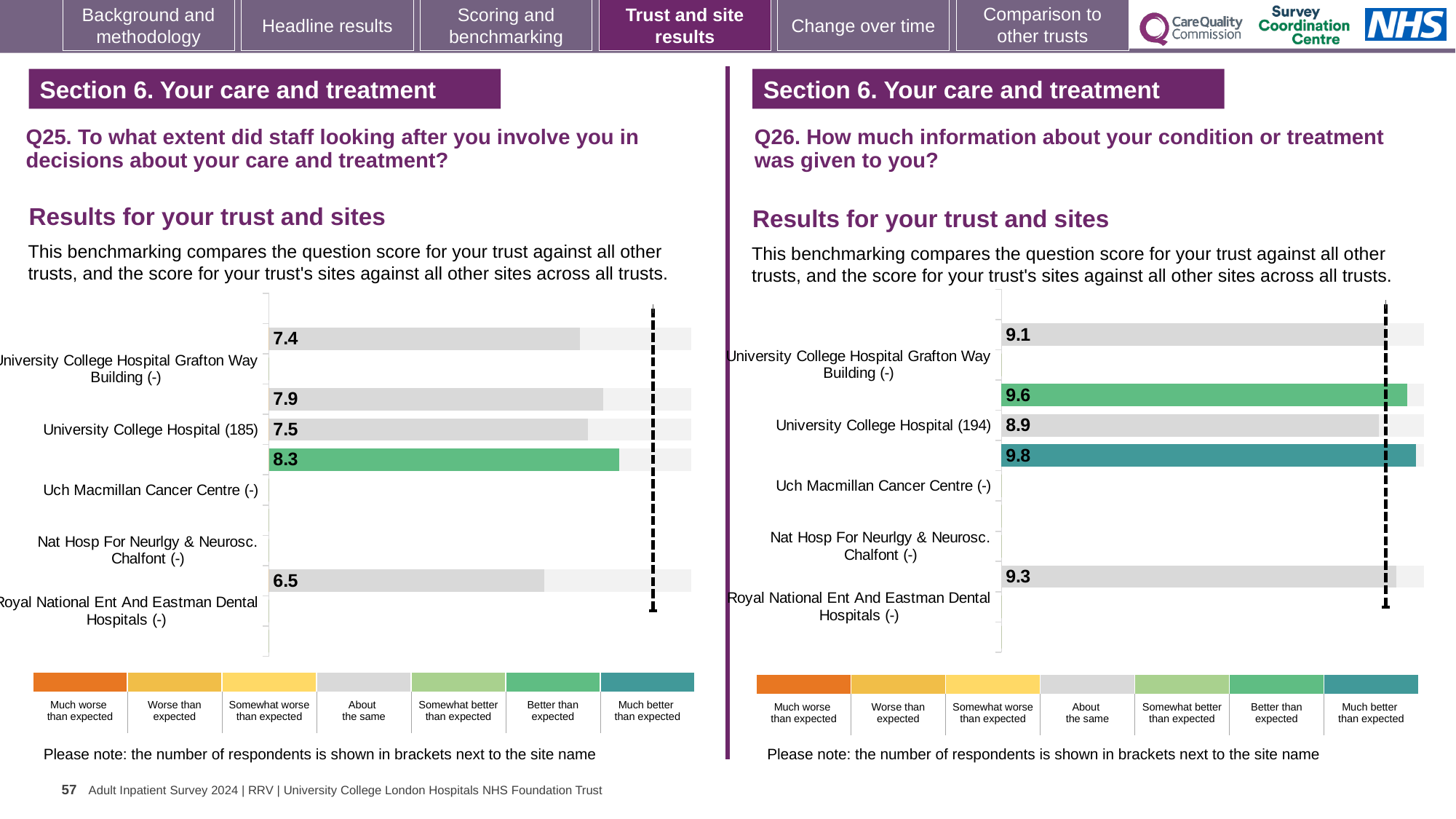
On the Q26 chart (right), which is larger, the bar labelled 9.6 or the bar labelled 9.1? 9.6 What kind of chart is used on the Q25 chart (left)? Bar chart On the Q26 chart (right), what is the difference between the highest bar value (9.8) and the lowest bar value (8.9)? 0.9 On the Q26 chart (right), what is the highest value shown on any bar? 9.8 On the Q25 chart (left), what is the lowest value shown on any bar? 6.5 How many categories does the colour key below the Q26 chart (right) list? 7 On the Q25 chart (left), what value is shown on the bar next to University College Hospital (185)? 7.5 On the Q25 chart (left), what is the difference between the highest bar value (8.3) and the lowest bar value (6.5)? 1.8 On the Q26 chart (right), what value is shown on the bar next to University College Hospital (194)? 8.9 On the Q25 chart (left), how many bars with data labels are plotted? 5 On the Q25 chart (left), what is the highest value shown on any bar? 8.3 On the Q26 chart (right), what is the lowest value shown on any bar? 8.9